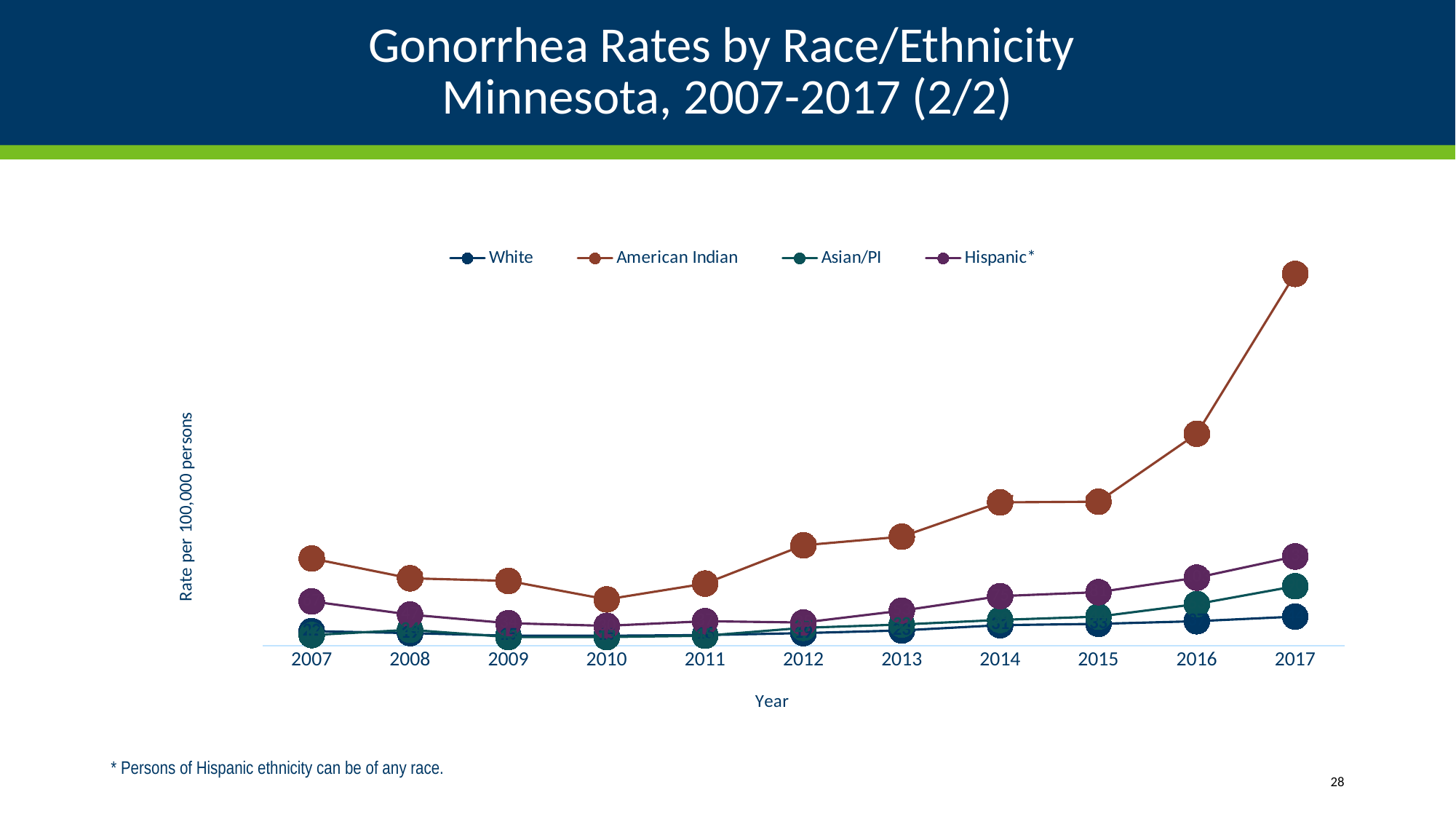
What kind of chart is shown on the slide? Line chart Which race/ethnicity group has the highest gonorrhea rate in 2017? American Indian In which year is the American Indian rate lowest? 2010 Does the American Indian rate rise or fall from 2010 to 2017? Rise How many series does the legend list? 4 How many years are plotted along the x axis? 11 In 2016, which is larger: the American Indian rate or the Hispanic rate? American Indian Which legend entry is marked with an asterisk? Hispanic Which race/ethnicity group has the lowest gonorrhea rate in 2017? White In which year is the American Indian rate highest? 2017 What is the label on the y axis? Rate per 100,000 persons In 2017, which is larger: the Hispanic rate or the Asian/PI rate? Hispanic